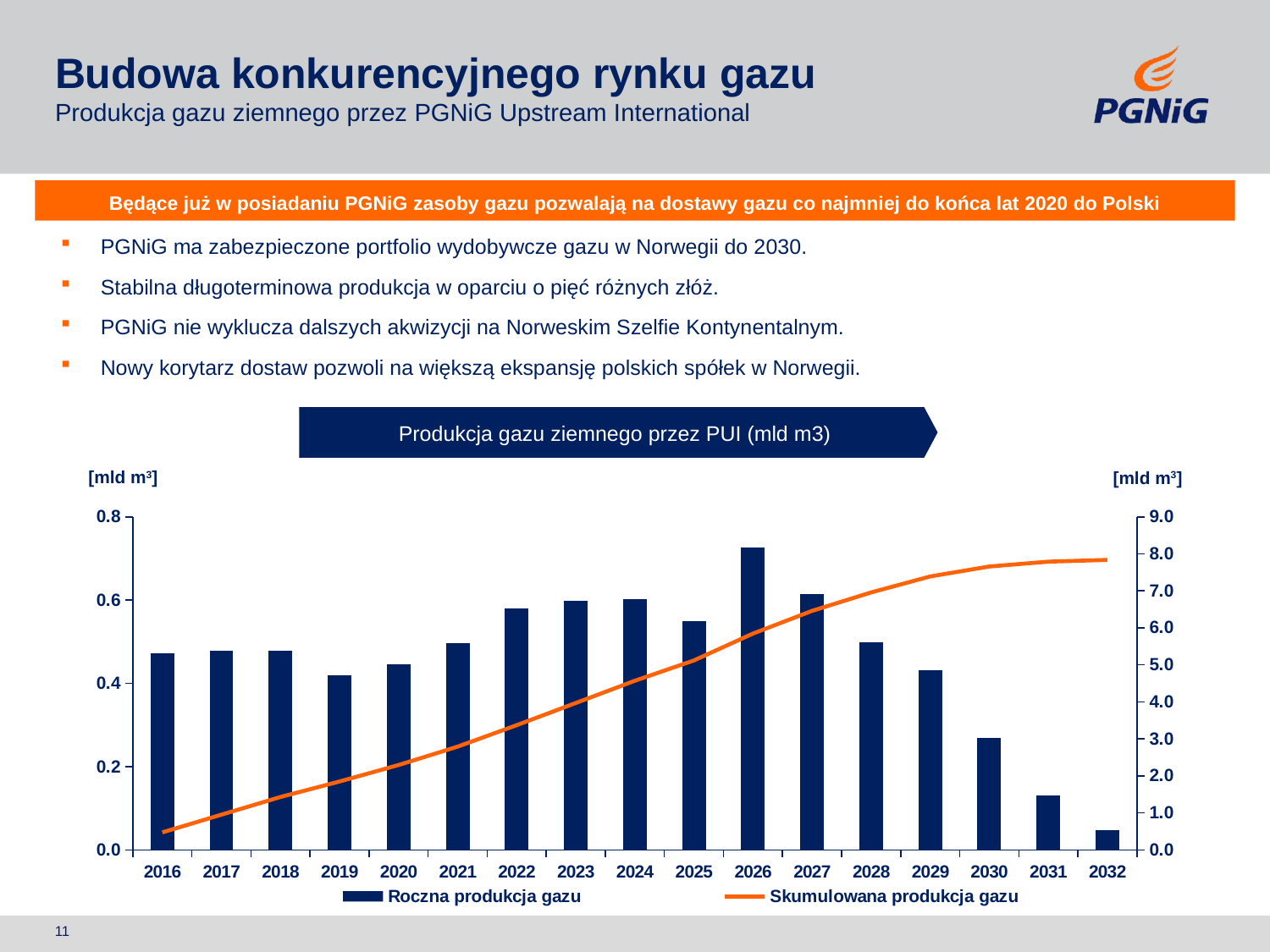
Is the Roczna produkcja gazu value for 2026 greater or less than 0.6? greater Which year has the highest bar for Roczna produkcja gazu? 2026 Which year has the larger Roczna produkcja gazu bar, 2019 or 2022? 2022 Is the Skumulowana produkcja gazu value for 2029 greater or less than 7.0? greater Is the Skumulowana produkcja gazu value for 2016 greater or less than 1.0? less What is the title of the chart? Produkcja gazu ziemnego przez PUI (mld m3) What kind of chart is shown on the slide? A combination chart with bars and a line Which year has the lowest bar for Roczna produkcja gazu? 2032 How many series does the chart legend list? 2 How many years are shown on the x axis of the chart? 17 Does the Skumulowana produkcja gazu line rise or fall from 2016 to 2032? rise